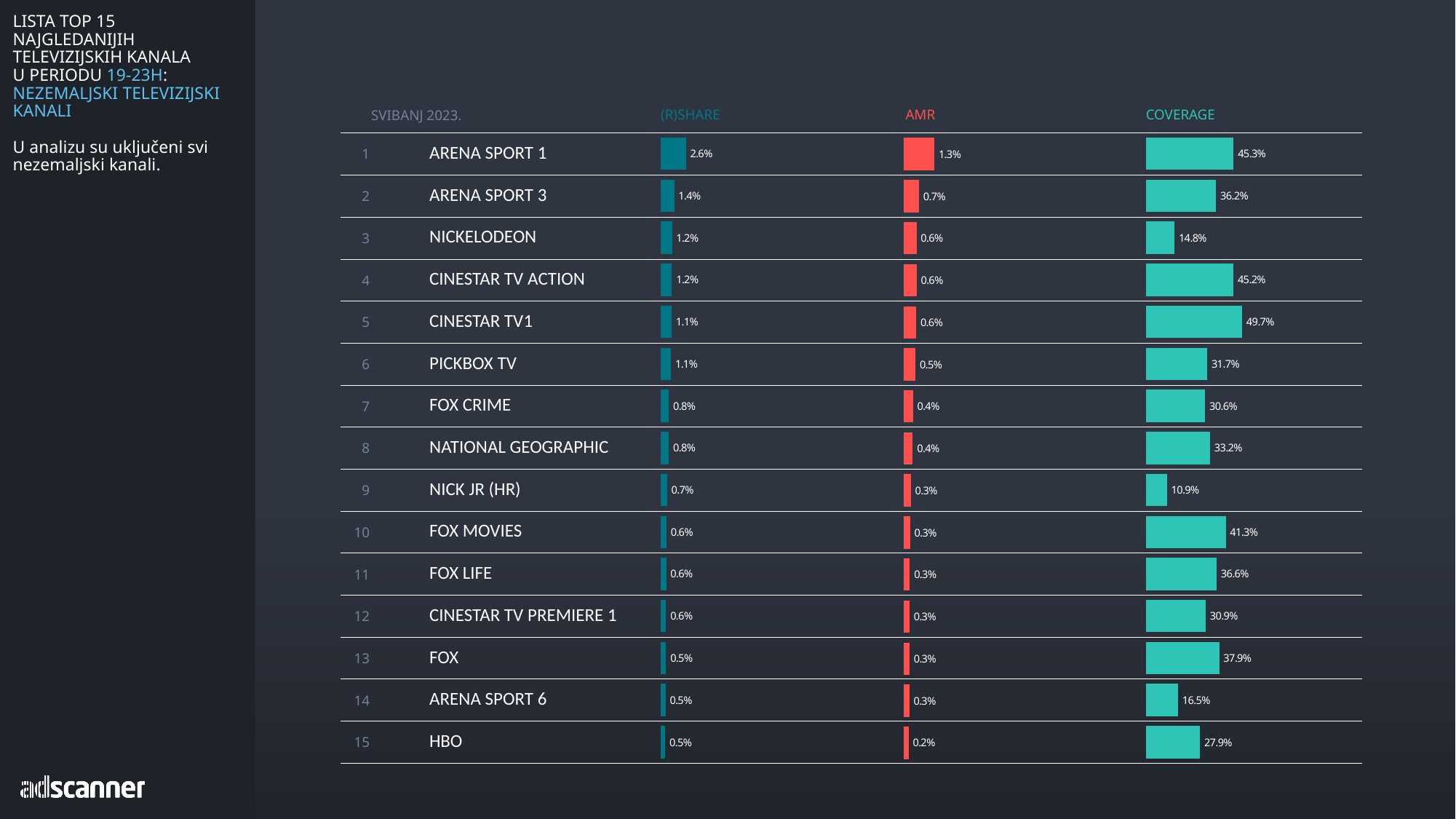
What kind of chart is used for the (R)SHARE, AMR and COVERAGE columns? Bar chart How many channels are listed in the charts? 15 In the COVERAGE chart, which channel has the lowest value? NICK JR (HR) In the COVERAGE chart, what is the value for CINESTAR TV1? 49.7% In the AMR chart, which channel has the lowest value? HBO In the COVERAGE chart, which is larger, FOX MOVIES or FOX LIFE? FOX MOVIES In the (R)SHARE chart, which channel has the highest value? ARENA SPORT 1 In the COVERAGE chart, which channel has the highest value? CINESTAR TV1 In the COVERAGE chart, what is the difference between ARENA SPORT 1 and NICKELODEON? 30.5% In the (R)SHARE chart, what is the value for ARENA SPORT 1? 2.6% In the AMR chart, what is the value for HBO? 0.2% In the (R)SHARE chart, what is the difference between ARENA SPORT 1 and ARENA SPORT 3? 1.2%